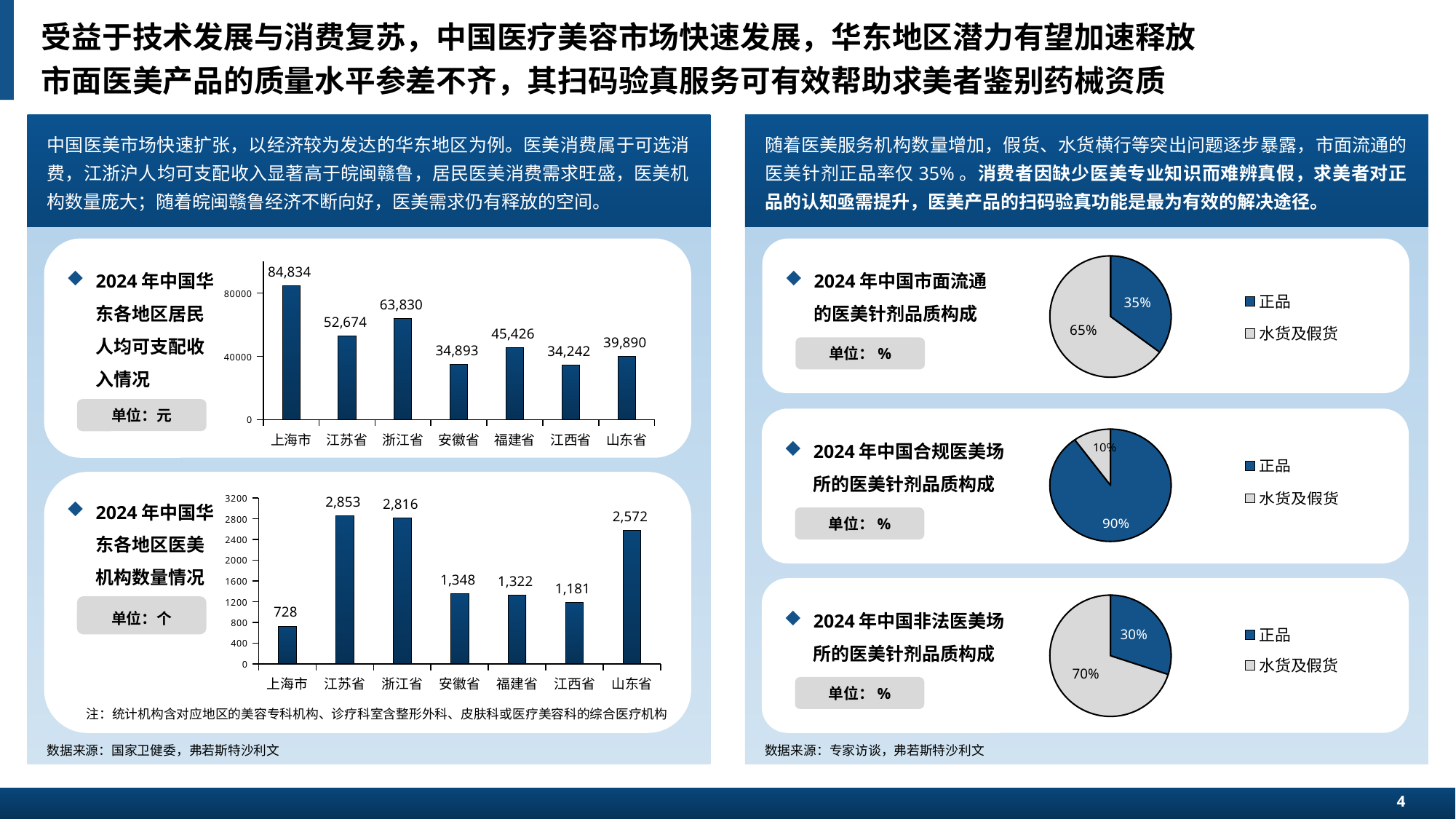
In the pie chart '2024年中国合规医美场所的医美针剂品质构成', what share is 正品? 90% In the chart '2024年中国华东各地区居民人均可支配收入情况', what is the value for 浙江省? 63,830 In the chart '2024年中国华东各地区医美机构数量情况', which is larger, 安徽省 or 福建省? 安徽省 In the pie chart '2024年中国非法医美场所的医美针剂品质构成', what share is 水货及假货? 70% In the chart '2024年中国华东各地区居民人均可支配收入情况', what is the difference between 上海市 and 江苏省? 32,160 How many series does the legend of the pie chart '2024年中国市面流通的医美针剂品质构成' list? 2 In the chart '2024年中国华东各地区医美机构数量情况', what is the value for 山东省? 2,572 In the chart '2024年中国华东各地区居民人均可支配收入情况', which region has the highest value? 上海市 How many regions are shown in the chart '2024年中国华东各地区医美机构数量情况'? 7 In the chart '2024年中国华东各地区医美机构数量情况', which region has the lowest value? 上海市 In the chart '2024年中国华东各地区居民人均可支配收入情况', which region has the lowest value? 江西省 What kind of chart is '2024年中国华东各地区医美机构数量情况'? bar chart